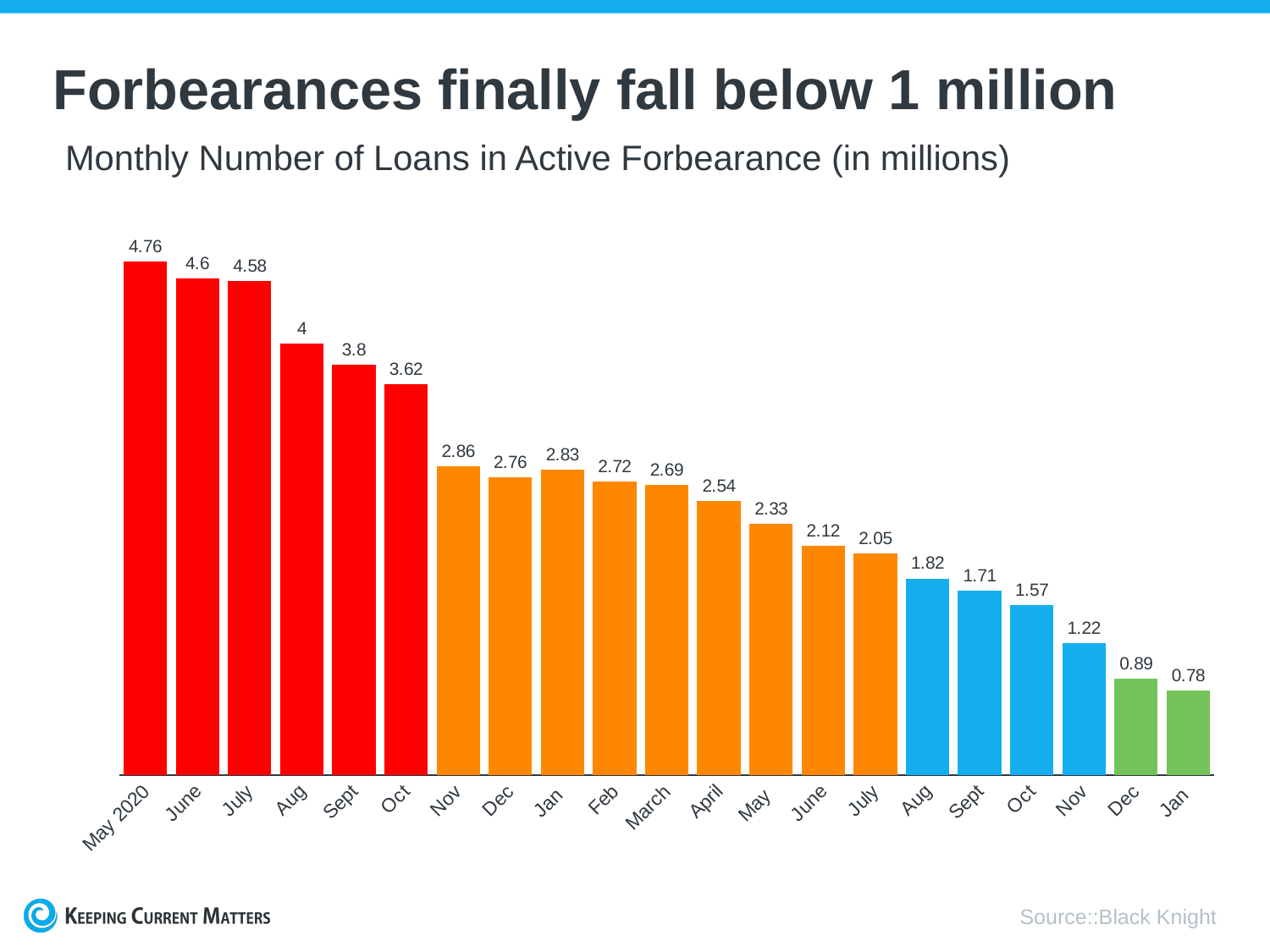
Which month has the lowest number of loans in active forbearance? Jan (the last bar) What kind of chart is shown on the slide? Bar chart What is the value for the last bar, Jan, at the right end of the chart? 0.78 What is the difference between the green Dec bar and the green Jan bar? 0.11 Which month has the highest number of loans in active forbearance? May 2020 What is the difference between the value for May 2020 and the value for the final Jan bar? 3.98 What is the value for May 2020? 4.76 What is the value for the second Oct bar (the blue Oct bar)? 1.57 Which is larger, the value for the first Aug bar (red) or the second Aug bar (blue)? The first Aug bar (red), 4 Do the values generally rise or fall from left to right across the months? Fall How many bars are plotted in the chart? 21 What is the value for the first Nov bar (the first orange bar)? 2.86